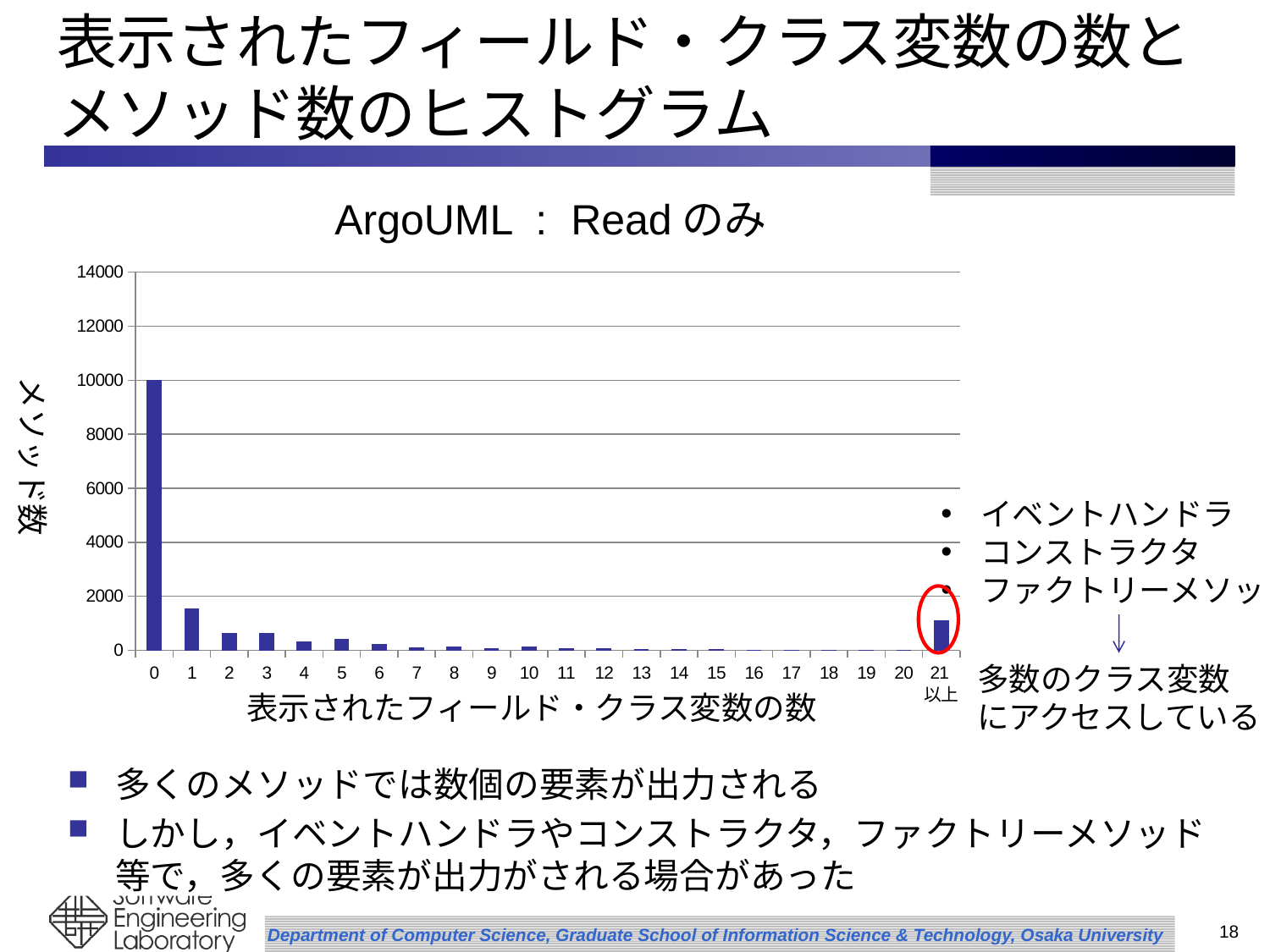
Which has a larger value, category 0 or category 1? 0 Is the value for category 1 greater or less than 2000? less Do the values generally rise or fall as the x axis goes from 0 to 20? fall How many categories are shown along the x axis of the chart? 22 What is the title of the chart? ArgoUML : Read のみ What kind of chart is shown on the slide? bar chart Which has a larger value, category 1 or category 2? 1 Is the value for category 0 greater or less than 8000? greater Which has a larger value, category 1 or category 21以上? 1 Is the value for category 21以上 greater or less than 2000? less Which category has the highest number of methods (メソッド数)? 0